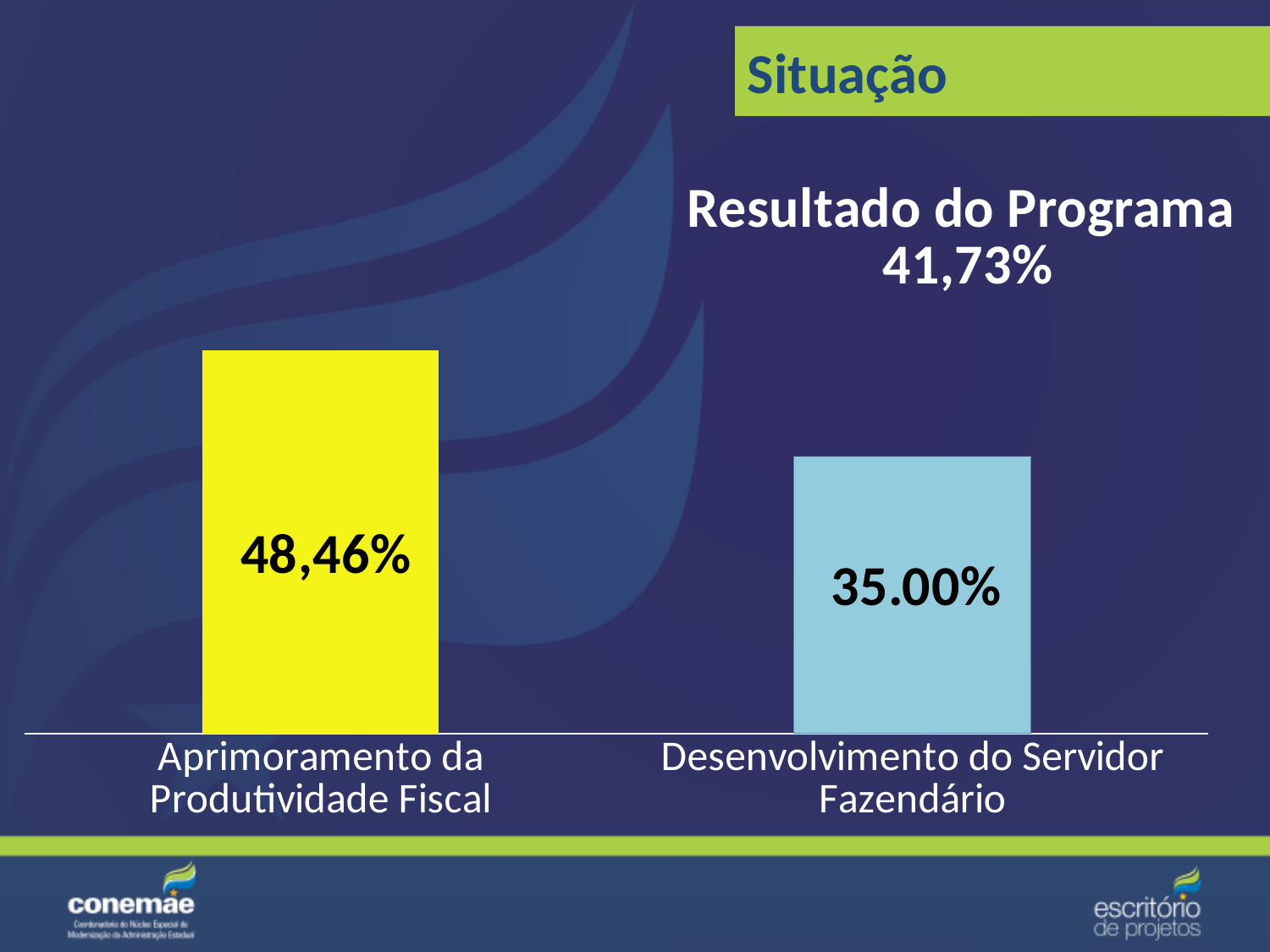
How many categories are shown in the chart? 2 What value is shown for Aprimoramento da Produtividade Fiscal? 48,46% What kind of chart is shown on the slide? Bar chart What colour is the bar for Aprimoramento da Produtividade Fiscal? Yellow What value is shown for Desenvolvimento do Servidor Fazendário? 35.00% What is the difference between the value for Aprimoramento da Produtividade Fiscal and the value for Desenvolvimento do Servidor Fazendário? 13,46% Which category has the highest value? Aprimoramento da Produtividade Fiscal Which is larger, the value for Aprimoramento da Produtividade Fiscal or for Desenvolvimento do Servidor Fazendário? Aprimoramento da Produtividade Fiscal Which category has the lowest value? Desenvolvimento do Servidor Fazendário What is the Resultado do Programa value stated on the slide? 41,73%